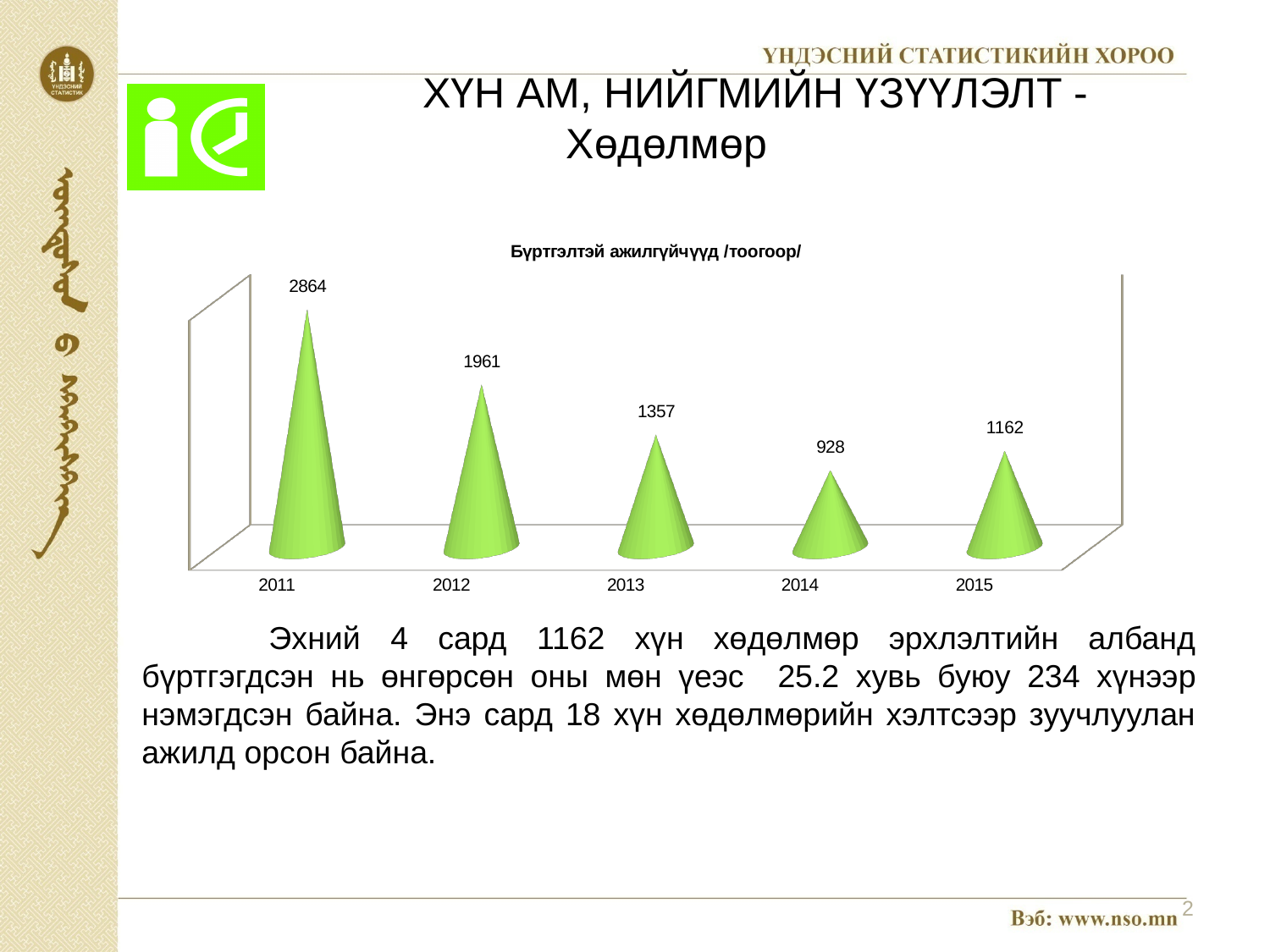
Which year has the highest value in the chart? 2011 What is the value for 2011 in the chart? 2864 Which is larger, the value for 2013 or the value for 2015? 2013 Do the values rise or fall from 2011 to 2014? fall What kind of chart is shown on the slide? bar chart What is the difference between the values for 2011 and 2012? 903 What is the value for 2015 in the chart? 1162 What is the difference between the values for 2015 and 2014? 234 Which year has the lowest value in the chart? 2014 How many years are shown on the x axis of the chart? 5 What is the value for 2014 in the chart? 928 What is the title of the chart? Бүртгэлтэй ажилгүйчүүд /тоогоор/